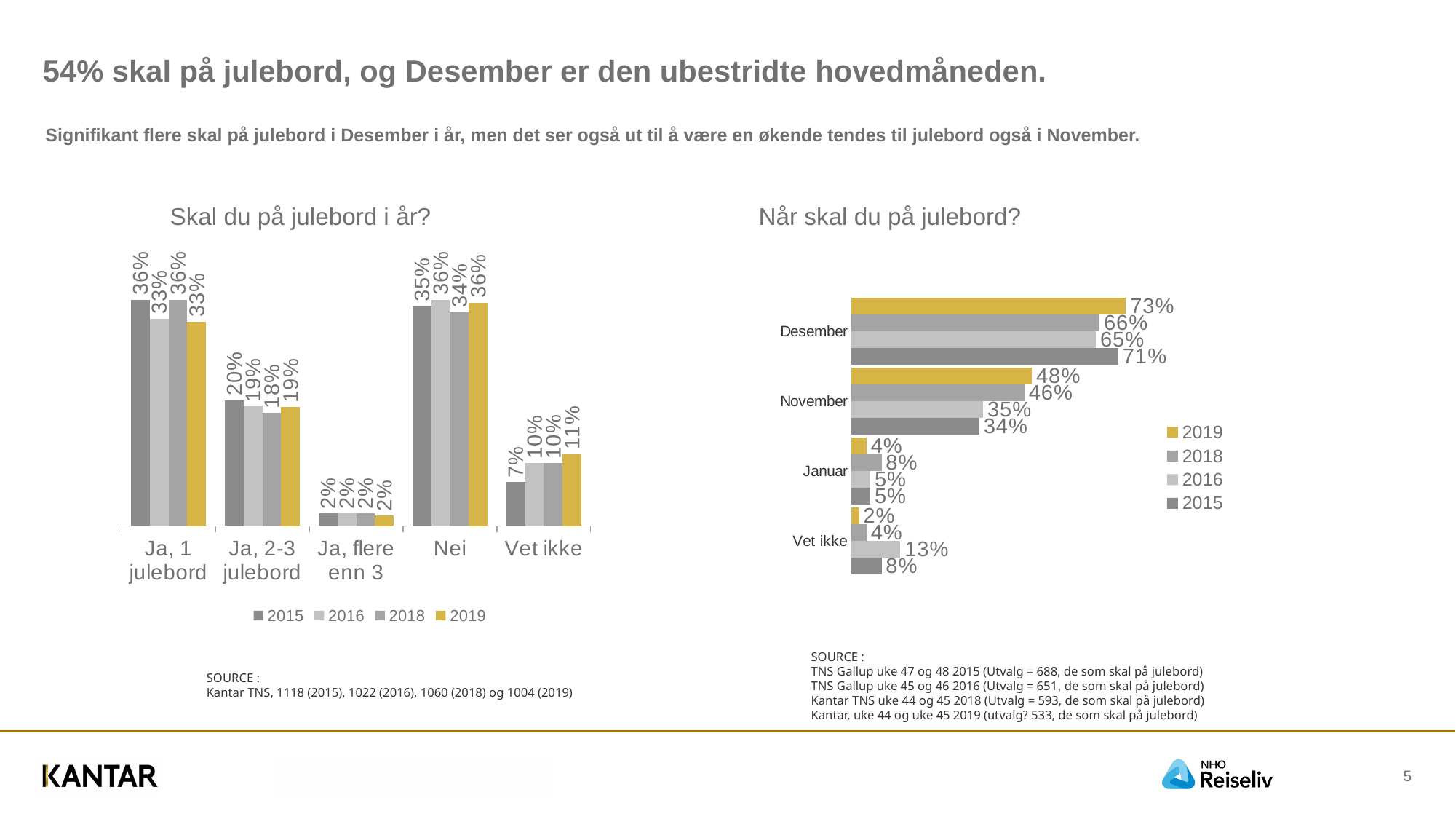
In the chart 'Skal du på julebord i år?', how many categories are shown on the x axis? 5 In the chart 'Skal du på julebord i år?', what is the value for 'Vet ikke' in 2019? 11% In the chart 'Når skal du på julebord?', which month has the highest value in 2019? Desember In the chart 'Når skal du på julebord?', what is the value for Desember in 2019? 73% In the chart 'Når skal du på julebord?', which is larger for Januar: the 2018 value or the 2019 value? 2018 What kind of chart is 'Når skal du på julebord?'? Bar chart In the chart 'Skal du på julebord i år?', what is the difference between the 2019 and 2015 values for 'Vet ikke'? 4% In the chart 'Når skal du på julebord?', which category has the lowest value in 2019? Vet ikke In the chart 'Skal du på julebord i år?', what is the value for 'Ja, 2-3 julebord' in 2015? 20% In the chart 'Når skal du på julebord?', what is the value for November in 2016? 35% In the chart 'Når skal du på julebord?', what is the difference between the 2019 and 2015 values for November? 14% In the chart 'Skal du på julebord i år?', how many series does the legend list? 4